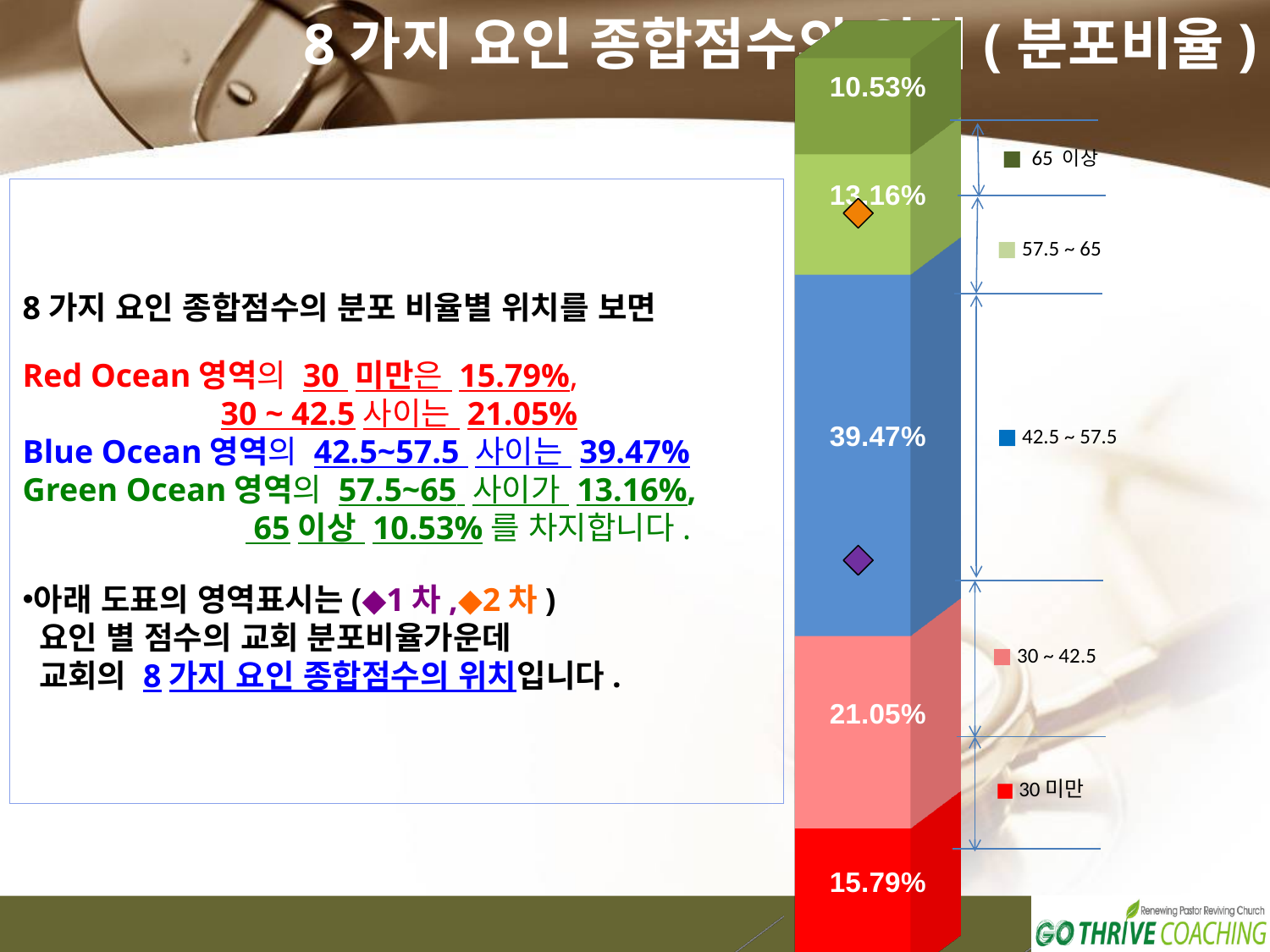
What is the difference between the 30 ~ 42.5 segment and the 30 미만 segment? 5.26% Which segment of the stacked bar has the smallest percentage? 65 이상 What percentage is shown for the 42.5 ~ 57.5 segment of the stacked bar? 39.47% What percentage is shown for the 30 미만 segment of the stacked bar? 15.79% Which is larger, the 57.5 ~ 65 segment or the 65 이상 segment? 57.5 ~ 65 What kind of chart is shown on the slide? Stacked bar chart How many segments make up the stacked bar? 5 Which segment of the stacked bar has the largest percentage? 42.5 ~ 57.5 What percentage is shown for the 57.5 ~ 65 segment of the stacked bar? 13.16% What percentage is shown for the 65 이상 segment of the stacked bar? 10.53% How many entries does the legend list? 5 What colour is the 30 미만 segment in the legend? Red